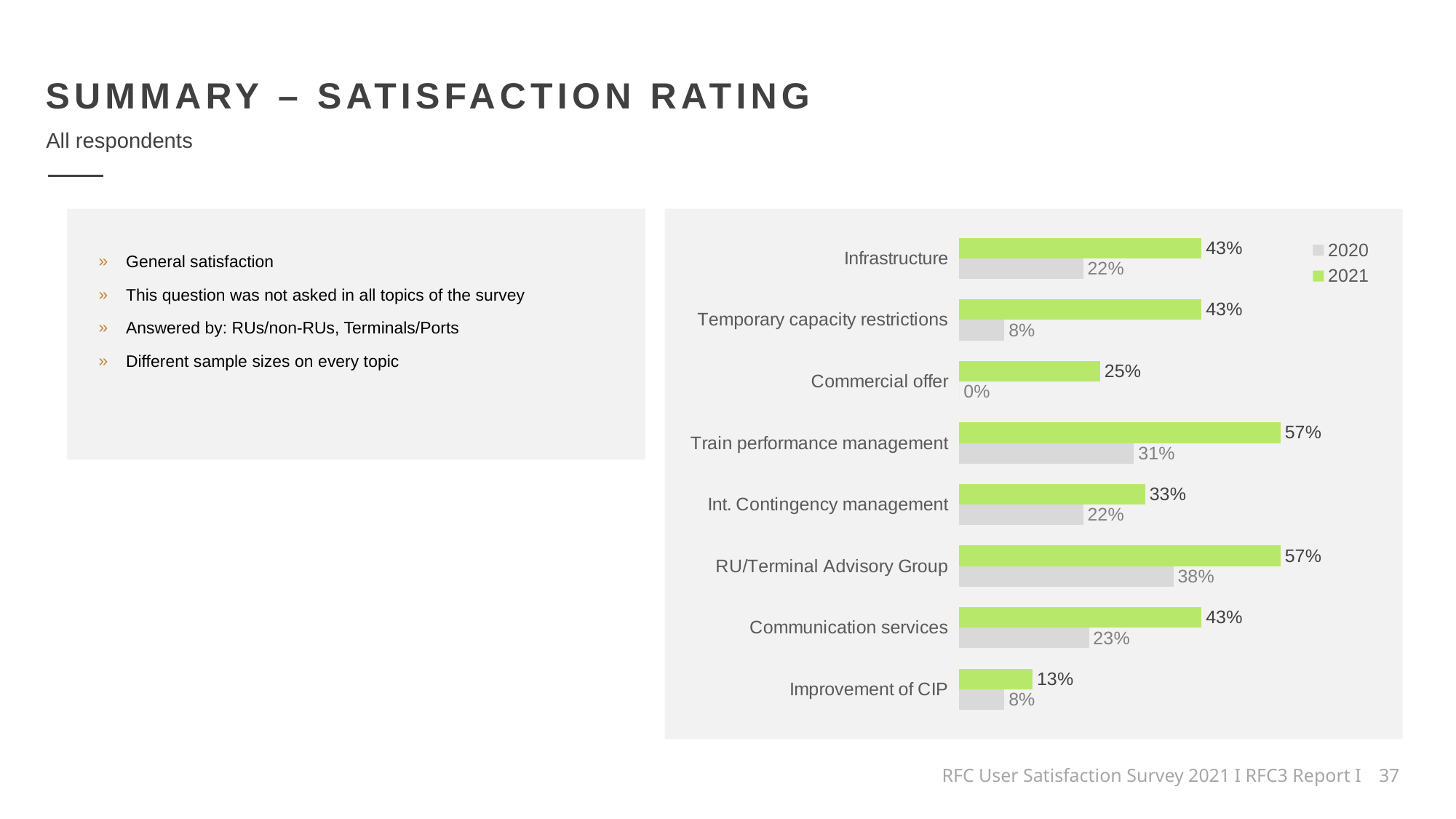
What kind of chart is shown on the slide? Bar chart How many categories are shown in the chart? 8 What is the 2021 value for Improvement of CIP? 13% Which series is shown in green in the chart? 2021 What is the 2020 value for Temporary capacity restrictions? 8% What is the difference between the 2021 and 2020 values for Infrastructure? 21% How many series does the legend list? 2 Which category has the lowest 2021 value? Improvement of CIP What is the 2021 value for Train performance management? 57% What is the 2020 value for Commercial offer? 0% Which is larger: the 2021 value for Int. Contingency management or the 2021 value for Communication services? Communication services Which category has the highest 2020 value? RU/Terminal Advisory Group